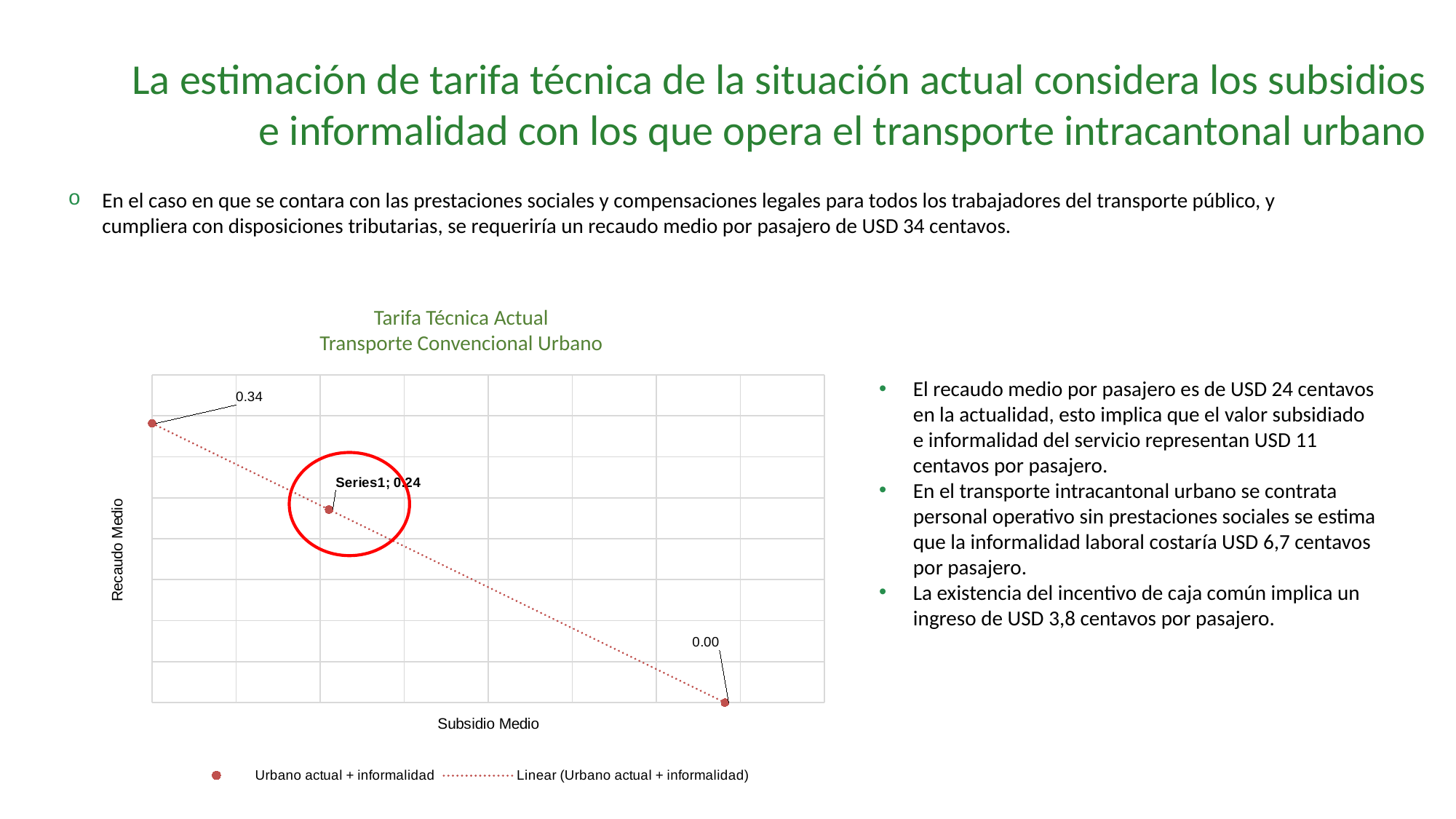
What is the lowest data label shown in the chart? 0.00 What value is shown by the data label inside the red circle? 0.24 What type of chart is shown on the slide? scatter chart How many entries does the legend list? 2 What is the title of the chart? Tarifa Técnica Actual Transporte Convencional Urbano Which is larger, the leftmost point's value or the circled point's value? the leftmost point (0.34) What is the label of the y axis? Recaudo Medio How many data points are plotted in the chart? 3 What is the highest data label shown in the chart? 0.34 Do the plotted values rise or fall as you move along the x axis from left to right? fall What is the label of the x axis? Subsidio Medio What is the difference between the highest labelled point (0.34) and the circled point (0.24)? 0.10